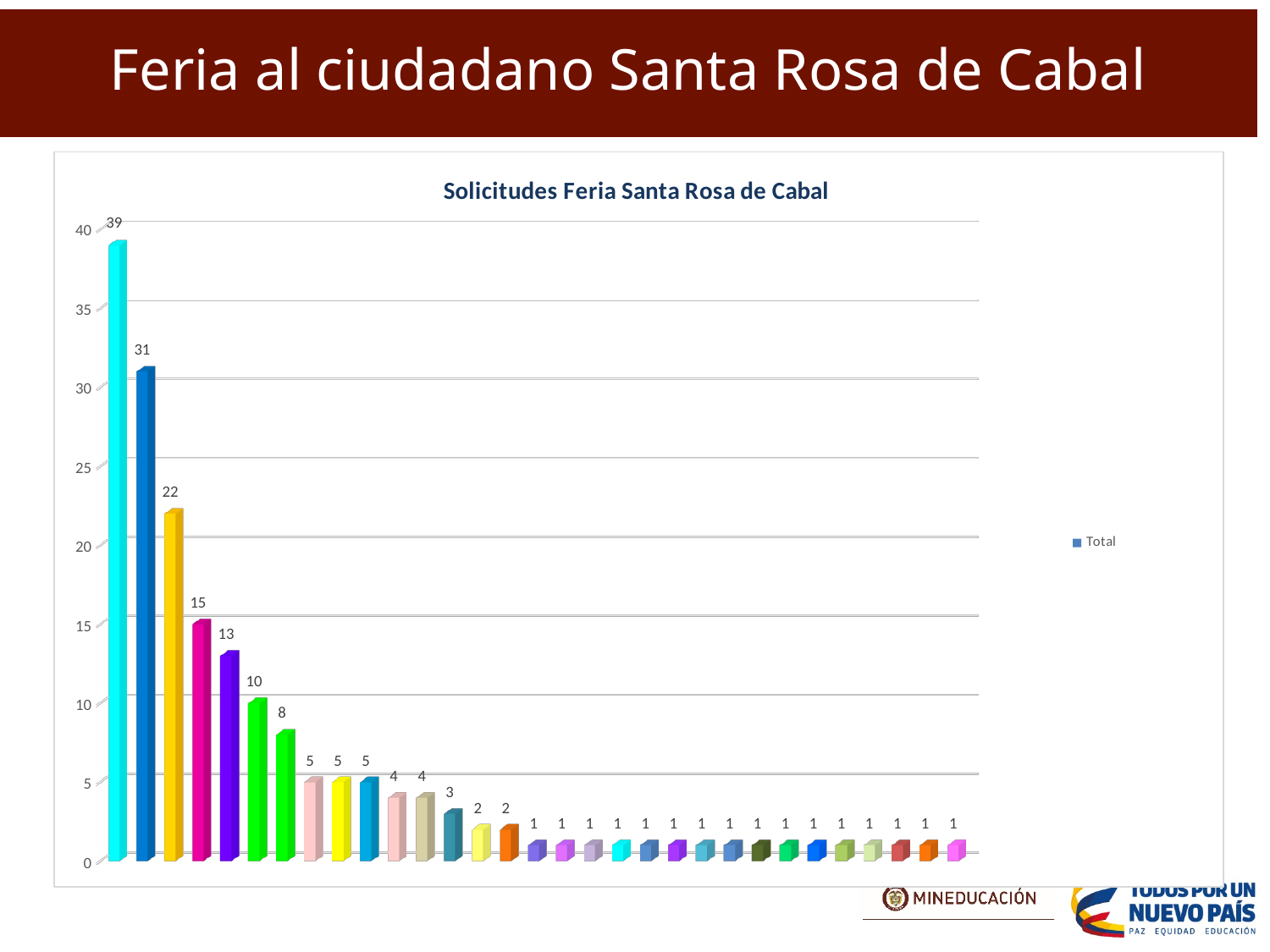
What is the value of the third bar from the left? 22 What entry does the chart legend list? Total What is the lowest value shown in the chart? 1 Do the bar values rise or fall from left to right along the x axis? fall Which is larger, the leftmost bar or the second bar from the left? the leftmost bar What is the title of the chart? Solicitudes Feria Santa Rosa de Cabal What is the highest value shown in the chart? 39 What is the difference between the tallest bar (39) and the second tallest bar (31)? 8 What kind of chart is shown on the slide? bar chart What is the value of the second bar from the left? 31 Is the value of the tallest bar greater or less than 35? greater How many series does the legend list? 1